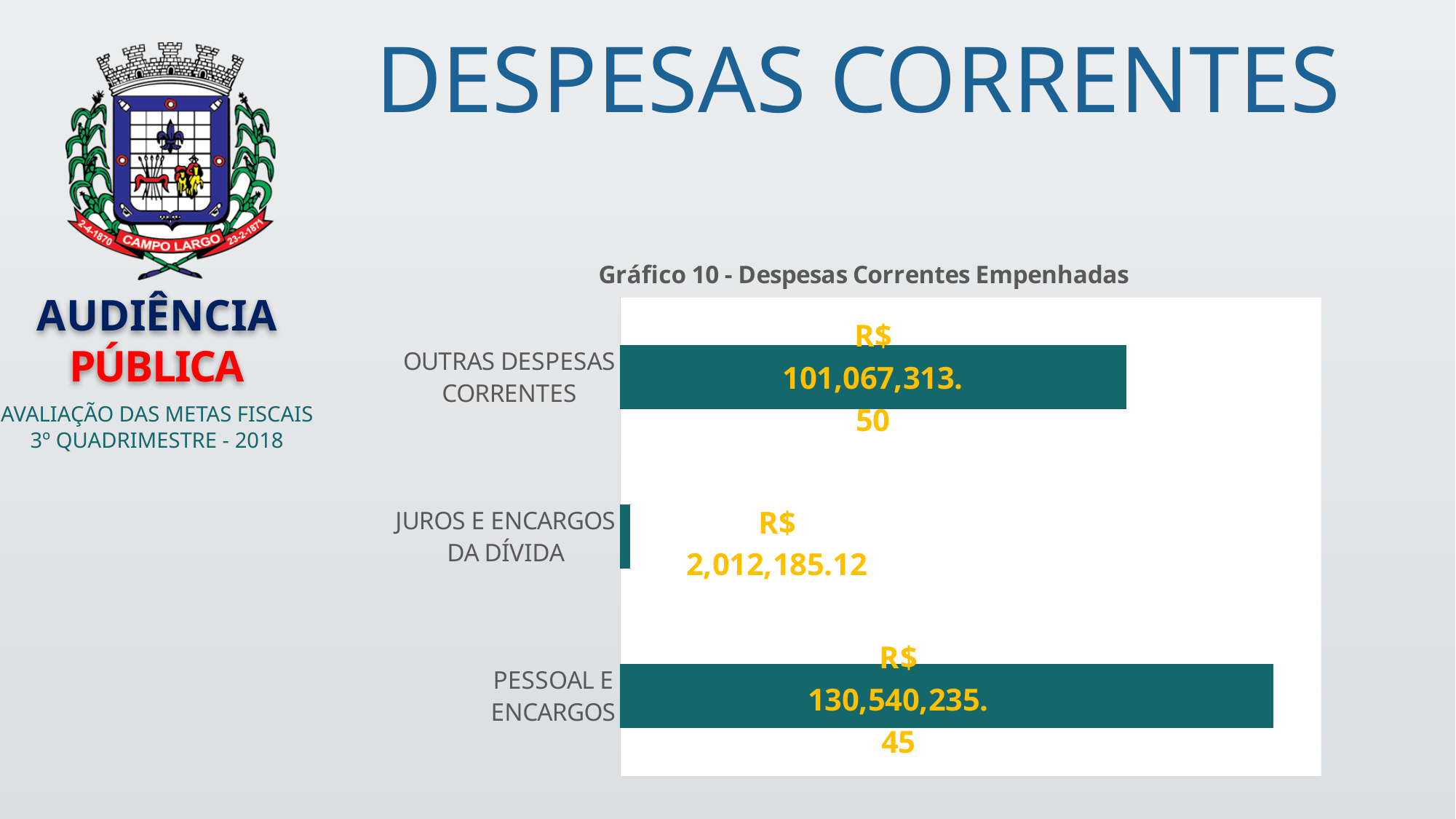
What kind of chart is shown on the slide? Bar chart What is the difference between PESSOAL E ENCARGOS and OUTRAS DESPESAS CORRENTES? R$ 29,472,921.95 What is the value for PESSOAL E ENCARGOS? R$ 130,540,235.45 Which category has the highest value? PESSOAL E ENCARGOS What is the value for JUROS E ENCARGOS DA DÍVIDA? R$ 2,012,185.12 What is the value for OUTRAS DESPESAS CORRENTES? R$ 101,067,313.50 What is the difference between OUTRAS DESPESAS CORRENTES and JUROS E ENCARGOS DA DÍVIDA? R$ 99,055,128.38 What is the title of the chart? Gráfico 10 - Despesas Correntes Empenhadas How many categories are shown in the chart? 3 Which is larger, OUTRAS DESPESAS CORRENTES or JUROS E ENCARGOS DA DÍVIDA? OUTRAS DESPESAS CORRENTES Which is larger, PESSOAL E ENCARGOS or OUTRAS DESPESAS CORRENTES? PESSOAL E ENCARGOS Which category has the lowest value? JUROS E ENCARGOS DA DÍVIDA